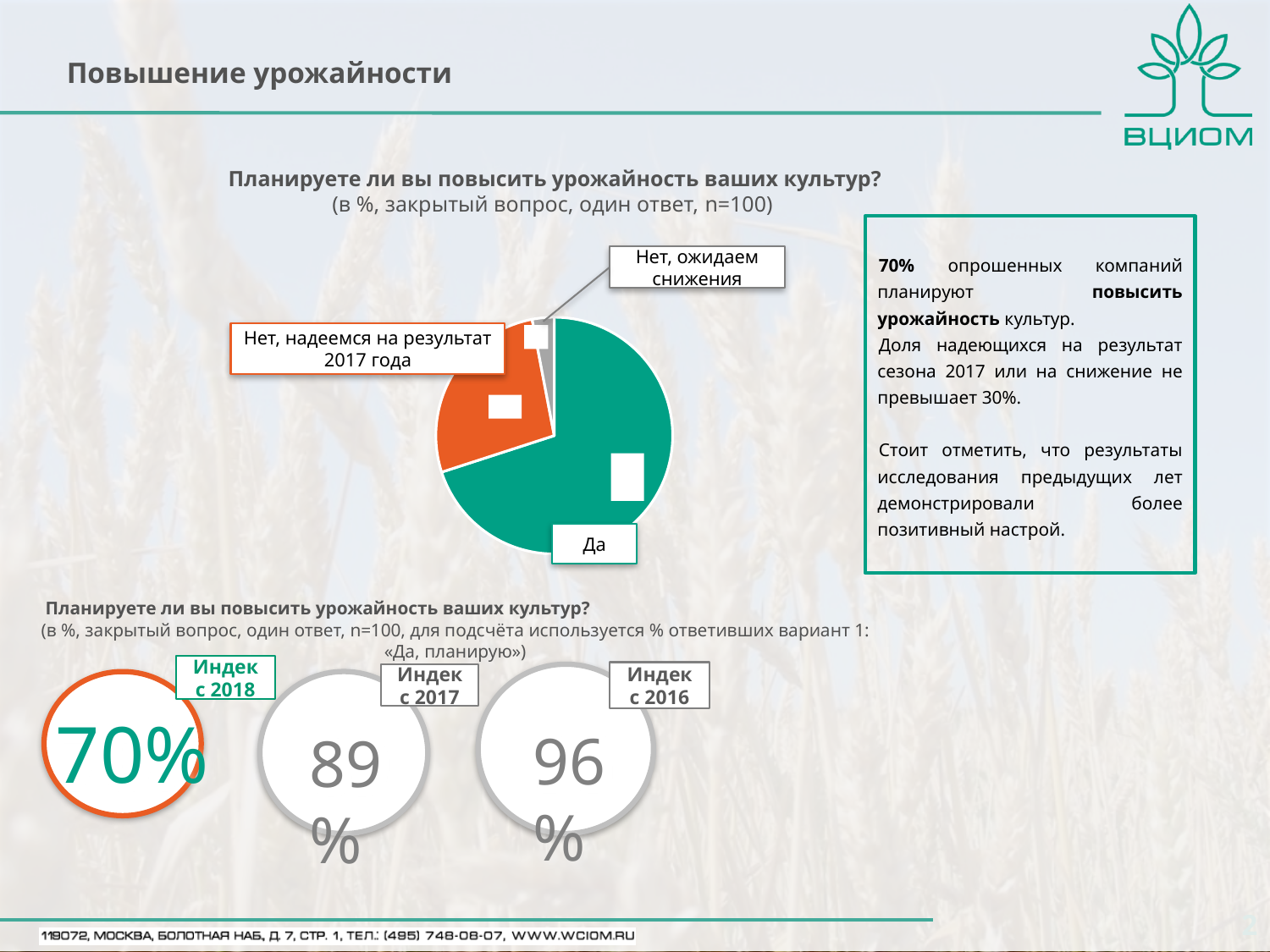
What is the sample size (n) stated under the pie chart's title? n=100 What colour is the "Да" slice in the pie chart? green In the pie chart, which slice is larger: "Да" or "Нет, надеемся на результат 2017 года"? Да In the index circles at the bottom of the slide, what is the value for "Индекс с 2017"? 89% What kind of chart is used to show the answers to "Планируете ли вы повысить урожайность ваших культур?"? pie chart In the index circles at the bottom of the slide, what is the difference between the 2016 value and the 2018 value? 26% In the pie chart, which slice is larger: "Нет, надеемся на результат 2017 года" or "Нет, ожидаем снижения"? Нет, надеемся на результат 2017 года In the index circles at the bottom of the slide, what is the value for "Индекс с 2016"? 96% How many slices does the pie chart have? 3 Which answer has the smallest slice in the pie chart? Нет, ожидаем снижения Which answer has the largest slice in the pie chart? Да In the index circles at the bottom of the slide, what is the value for "Индекс с 2018"? 70%